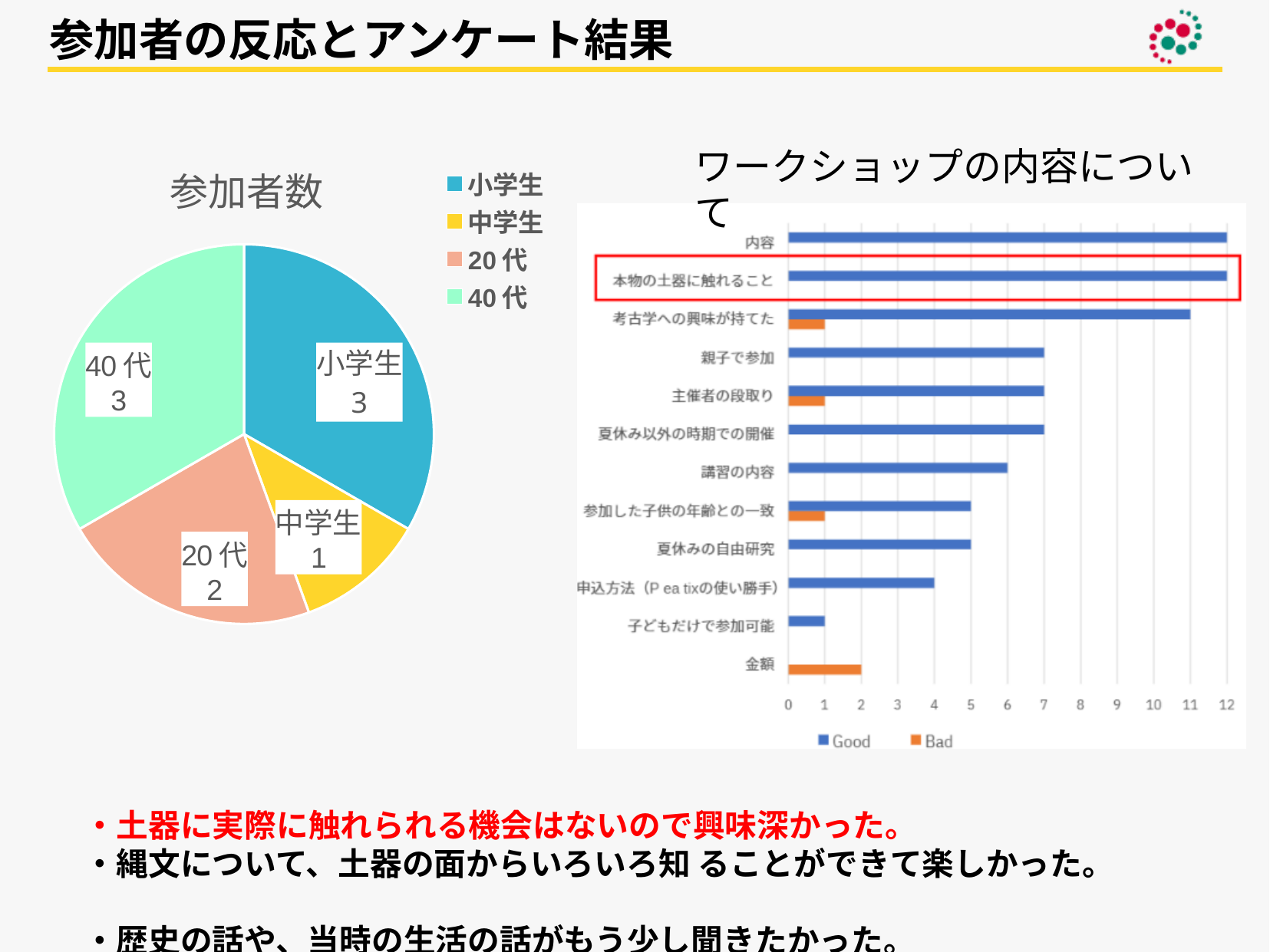
In the bar chart ワークショップの内容について, which is larger, the Good value for 講習の内容 or the Good value for 申込方法（Peatixの使い勝手）? 講習の内容 In the pie chart 参加者数, how many categories are shown? 4 In the pie chart 参加者数, how many participants are 中学生? 1 What kind of chart is the chart titled ワークショップの内容について? bar chart In the bar chart ワークショップの内容について, how many series does the legend list? 2 In the pie chart 参加者数, how many participants are 小学生? 3 In the pie chart 参加者数, which category has the fewest participants? 中学生 In the bar chart ワークショップの内容について, is the Good value for 親子で参加 greater or less than 6? greater In the pie chart 参加者数, what is the total number of participants across all categories? 9 In the bar chart ワークショップの内容について, what is the Good value for 考古学への興味が持てた? 11 In the pie chart 参加者数, what is the difference between the number of 40代 and 20代 participants? 1 In the bar chart ワークショップの内容について, what is the Bad value for 金額? 2